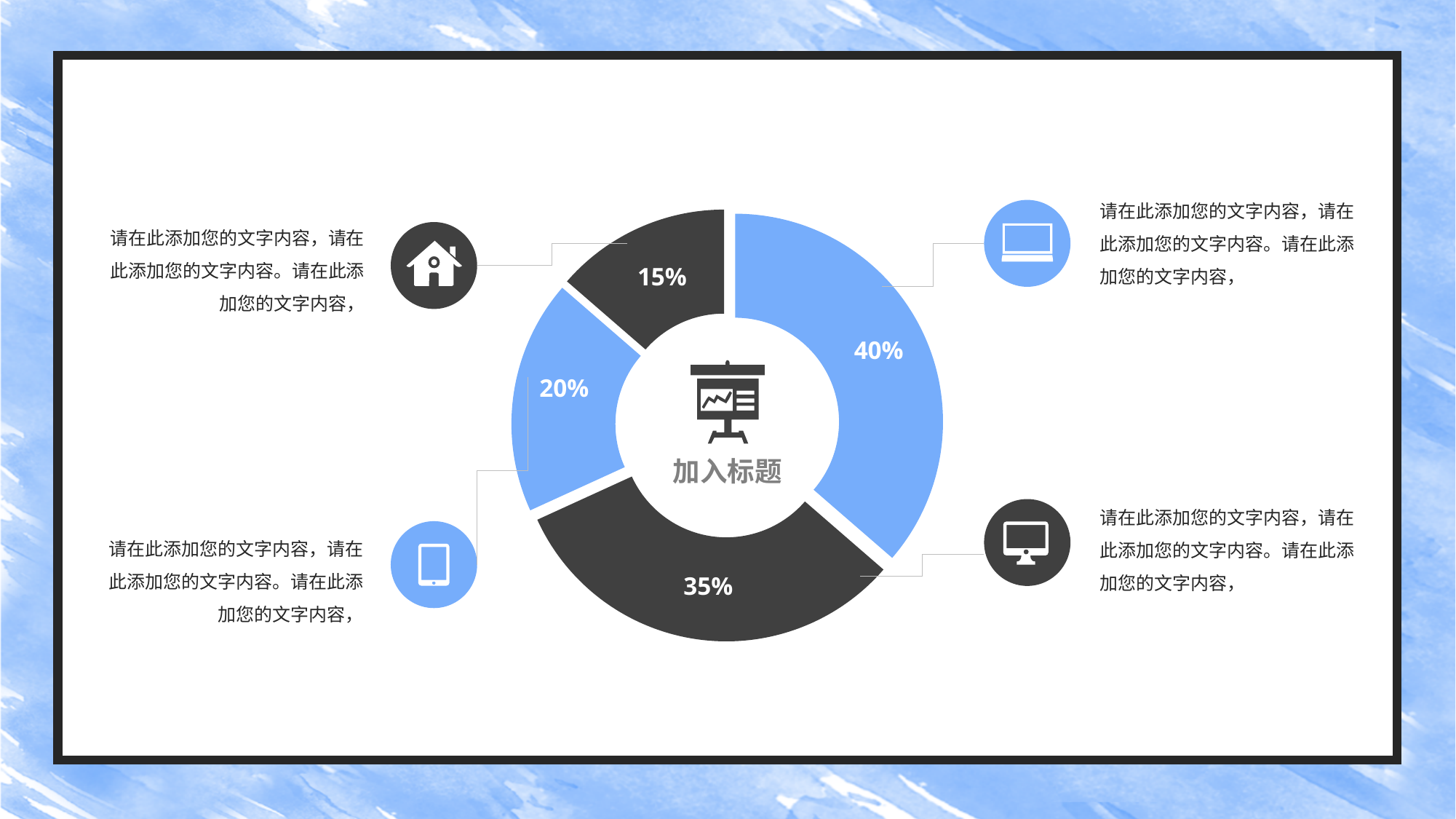
Which is larger: the blue slice on the right or the dark slice at the bottom? the blue slice on the right (40%) What kind of chart is shown on the slide? donut (pie) chart What text is shown in the centre of the donut chart? 加入标题 What is the difference between the largest and smallest slices in the donut chart? 25% What is the value of the smallest slice in the donut chart? 15% How many different colours are used for the slices of the donut chart? 2 What value is shown on the dark slice at the bottom of the donut chart? 35% What is the difference between the 40% slice and the 35% slice? 5% What is the value of the largest slice in the donut chart? 40% How many slices does the donut chart have? 4 What value is shown on the blue slice on the left side of the donut chart? 20% What value is shown on the slice connected to the house icon? 15%